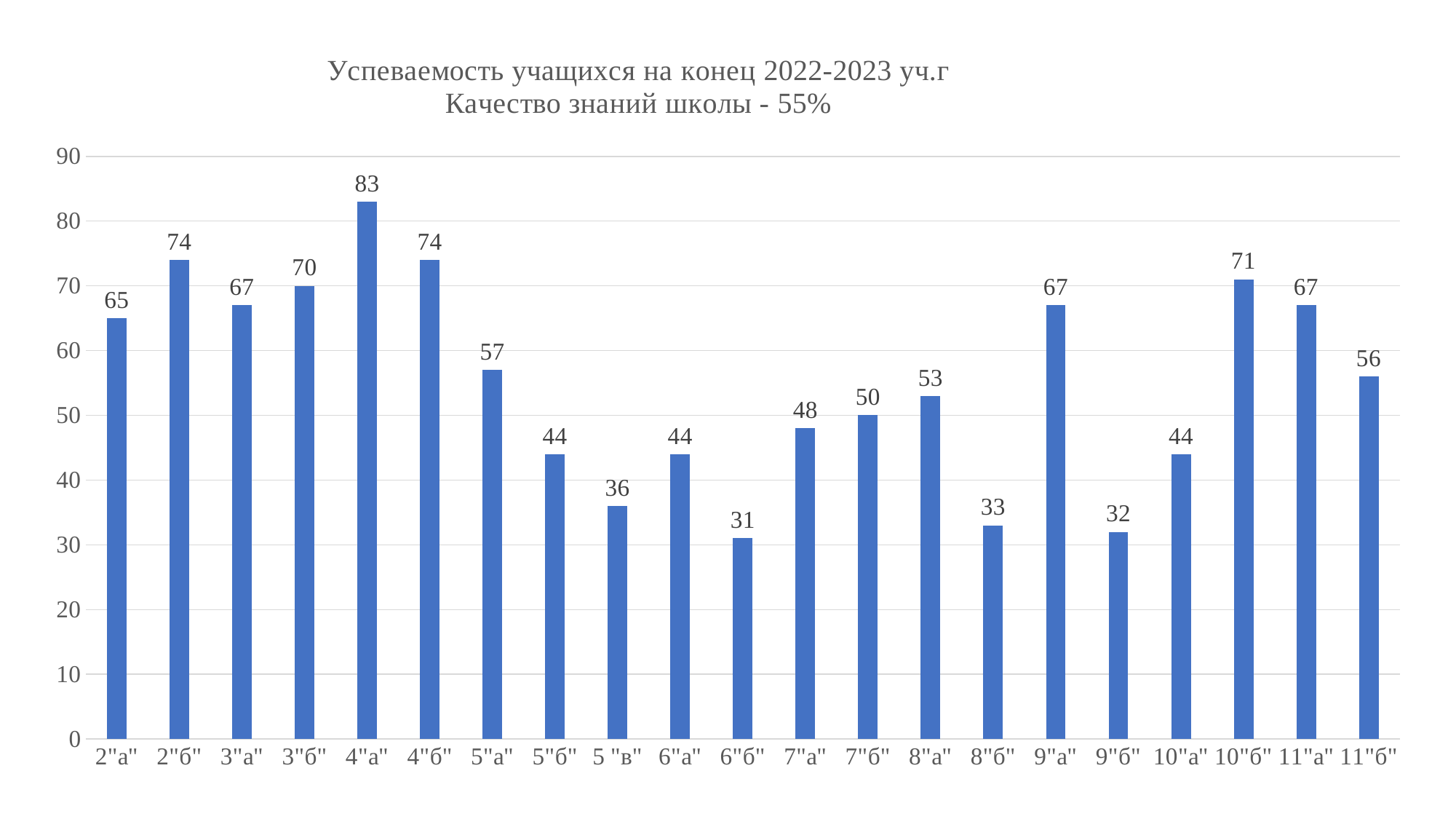
Which class has the lowest value? 6"б" What kind of chart is shown on the slide? bar chart What is the value for 4"а"? 83 What is the value for 11"б"? 56 Is the value for 7"а" greater or less than 50? less What is the value for 9"б"? 32 What school-wide quality of knowledge percentage is stated in the chart title? 55% Which is larger, the value for 5"а" or the value for 8"а"? 5"а" Which class has the highest value? 4"а" What is the difference between the values for 10"б" and 10"а"? 27 How many classes are shown on the x axis? 21 What is the difference between the values for 4"а" and 6"б"? 52